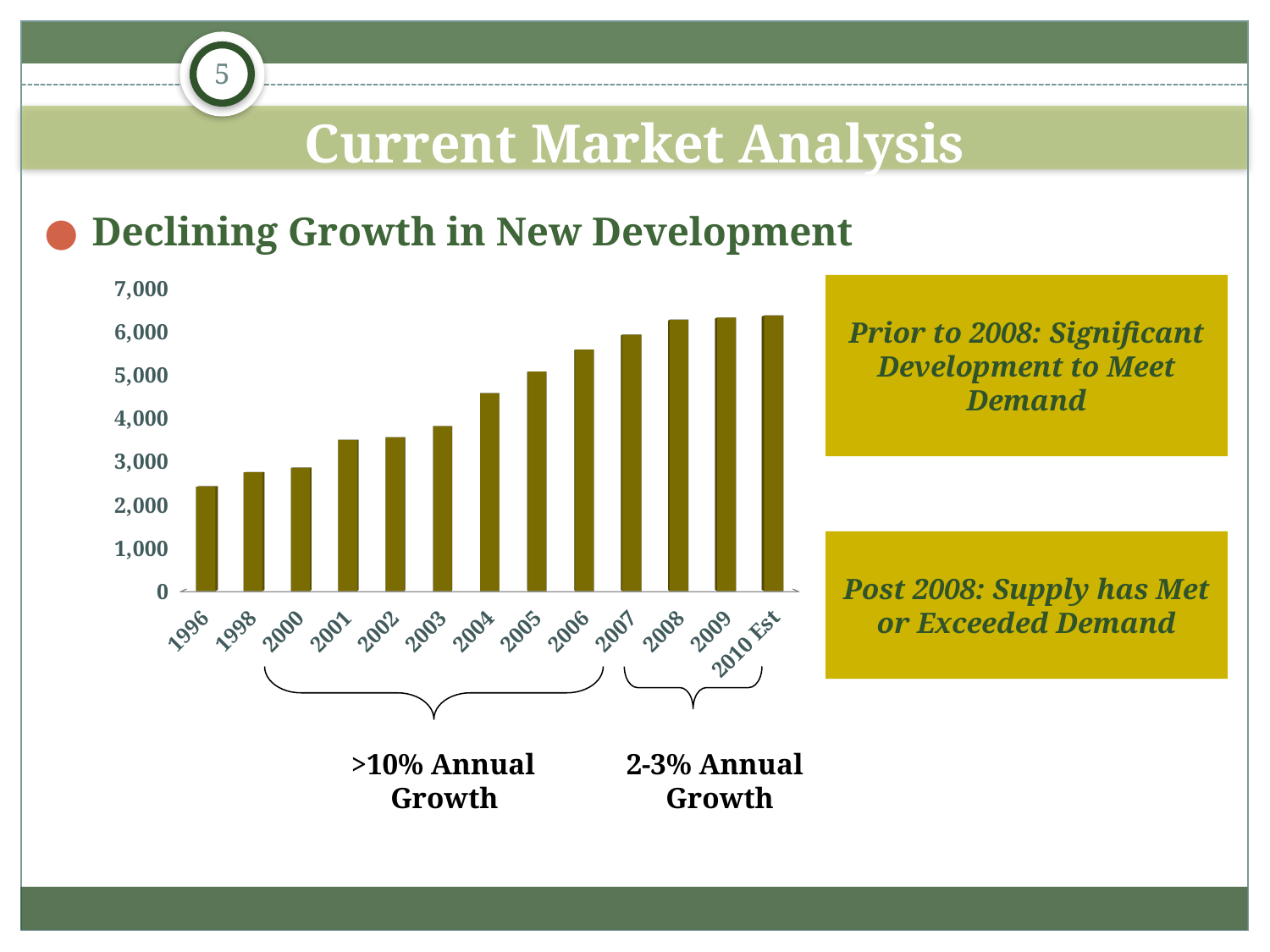
How many years (categories) are plotted on the x axis of the chart? 13 Is the value for 2006 greater or less than 5,000? greater Which is larger, the value for 2000 or the value for 2004? 2004 Is the value for 1996 greater or less than 3,000? less Is the value for 2004 greater or less than 4,000? greater Do the values generally rise or fall from 1996 to 2010 Est? rise What is the heading above the chart? Declining Growth in New Development What kind of chart is shown on the slide? bar chart What annual growth rate label is shown under the bracket covering 2007 to 2010 Est? 2-3% Annual Growth Which year has the lowest value in the chart? 1996